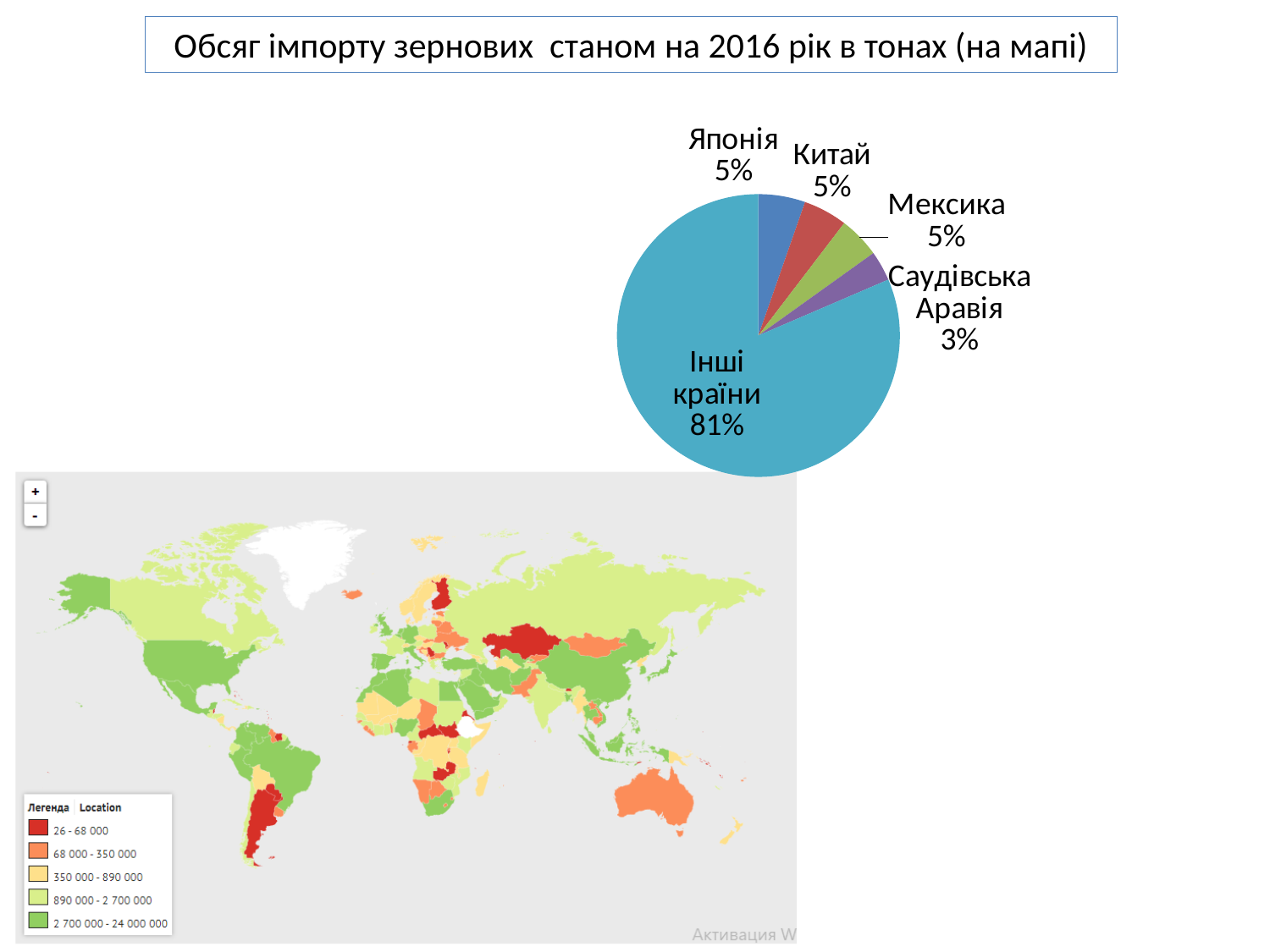
What is the value shown for Мексика in the pie chart? 5% What is the combined share of Японія, Китай and Мексика in the pie chart? 15% Which slice of the pie chart is the largest? Інші країни What is the value shown for Японія in the pie chart? 5% Which named country has the smallest slice in the pie chart? Саудівська Аравія What kind of chart is shown on the slide? pie chart What colour is the Інші країни slice in the pie chart? blue (teal) What is the value shown for Саудівська Аравія in the pie chart? 3% How many slices does the pie chart have? 5 What is the difference between the shares of Інші країни and Китай? 76% Which is larger in the pie chart, Мексика or Саудівська Аравія? Мексика What share of the pie does Інші країни hold? 81%